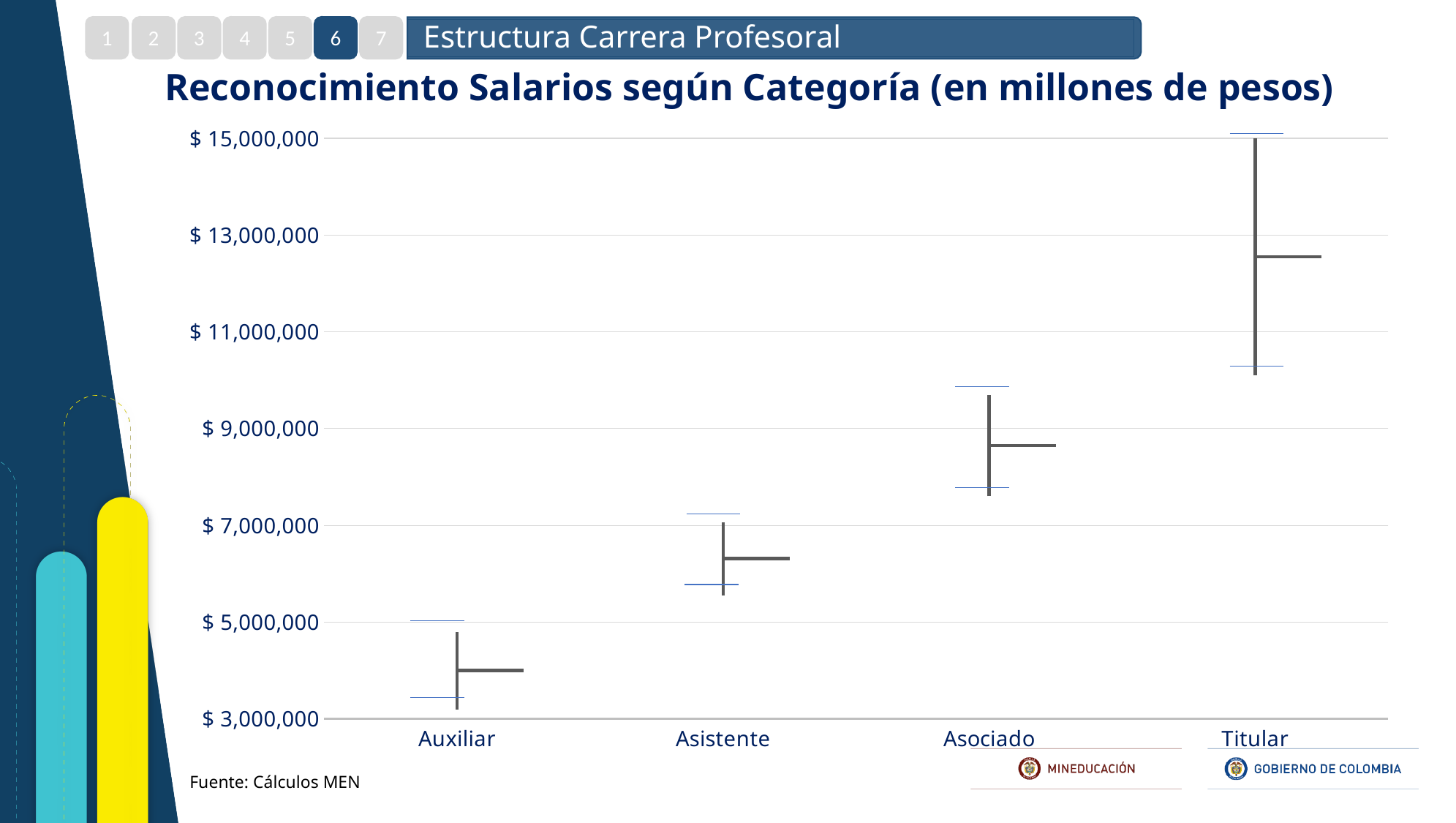
Is the horizontal marker value for Titular greater or less than $ 13,000,000? less What is the title of the chart? Reconocimiento Salarios según Categoría (en millones de pesos) Which category has the highest salary values in the chart? Titular How many categories are shown on the x axis of the chart? 4 Is the horizontal marker value for Asistente greater or less than $ 7,000,000? less Is the lowest point of the Titular range greater or less than $ 11,000,000? less Which category has a larger horizontal marker value, Asociado or Asistente? Asociado What kind of chart is shown on the slide? Stock (high-low) chart Do the salary values rise or fall moving from Auxiliar to Titular along the x axis? Rise Which category has the lowest salary values in the chart? Auxiliar